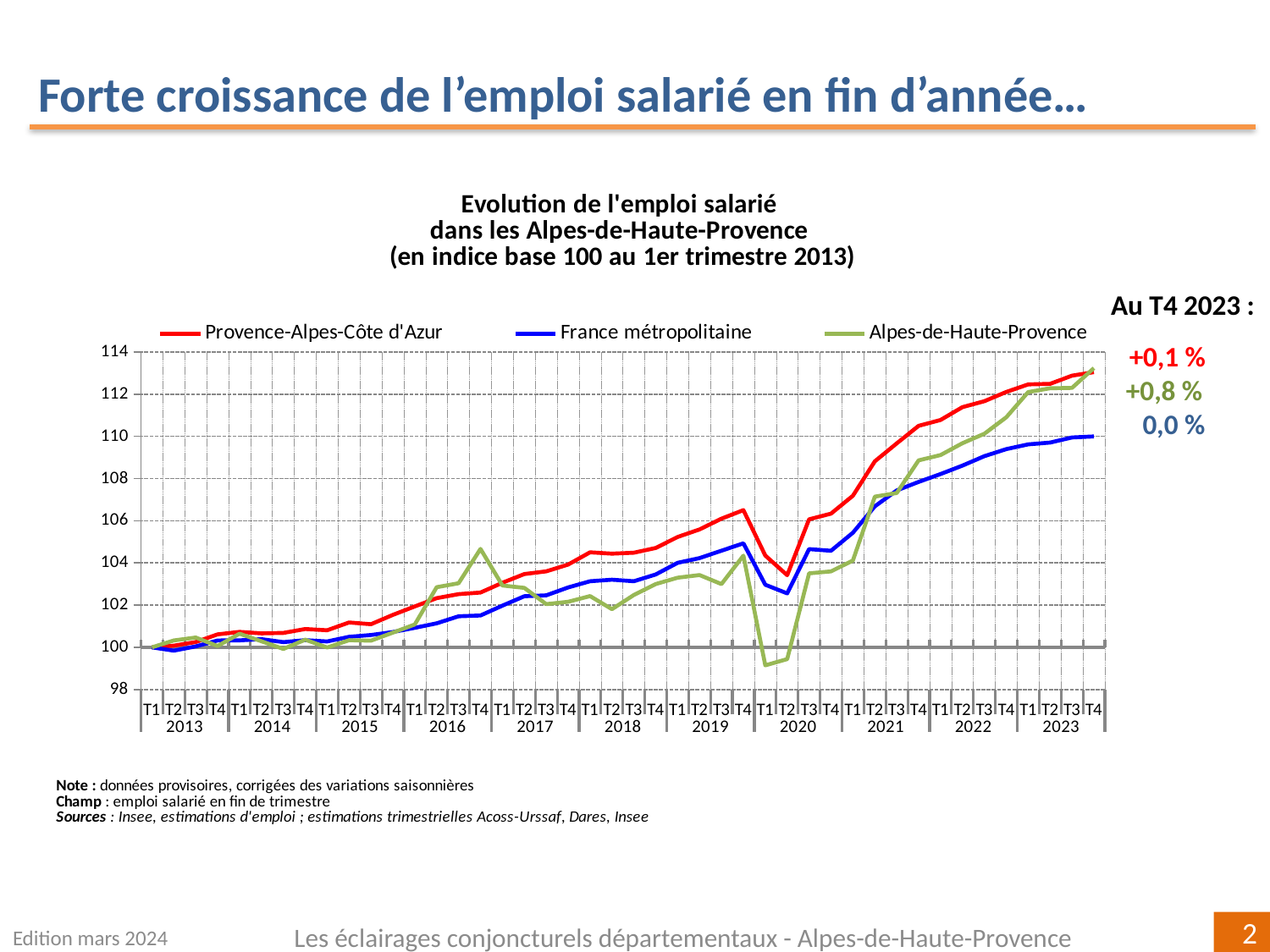
What type of chart is shown on the slide? line chart Is the value for Provence-Alpes-Côte d'Azur at T4 2019 greater or less than 104? greater What change is shown for Alpes-de-Haute-Provence at T4 2023 in the annotation to the right of the chart? +0,8 % How many series does the legend list? 3 Is the value for France métropolitaine at T4 2023 greater or less than 108? greater Which series has the lowest value at T1 2020? Alpes-de-Haute-Provence At T4 2023, which series is higher: Provence-Alpes-Côte d'Azur or France métropolitaine? Provence-Alpes-Côte d'Azur How many years are shown on the x axis? 11 What colour is the France métropolitaine line? blue Is the value for Alpes-de-Haute-Provence at T1 2020 greater or less than 100? less Which series are listed in the legend? Provence-Alpes-Côte d'Azur, France métropolitaine, Alpes-de-Haute-Provence Does the France métropolitaine series rise or fall between T1 2021 and T4 2023? rise